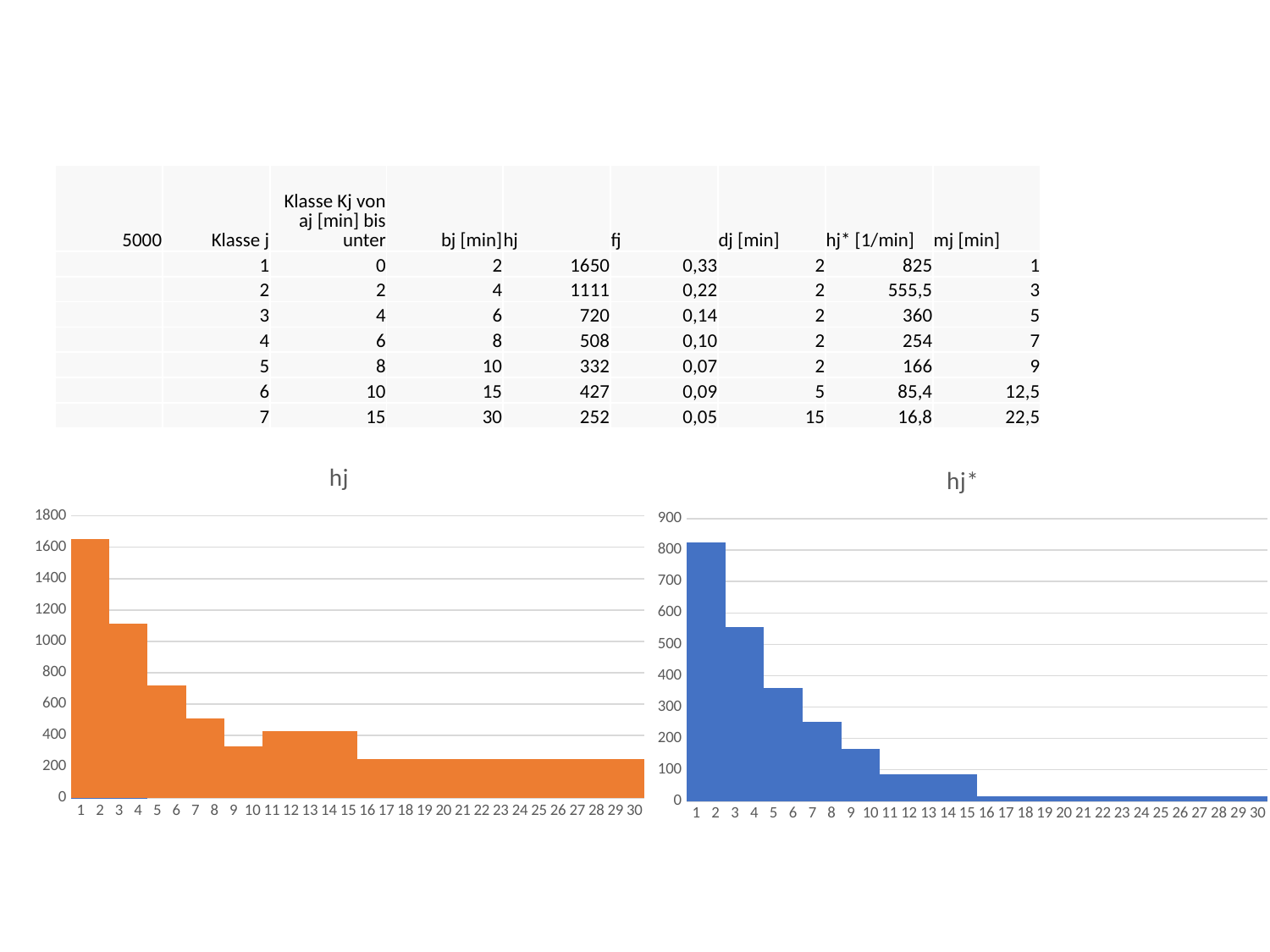
In the chart titled "hj*", is the value at x = 16 greater or less than 100? less What is the title of the left chart? hj In the chart titled "hj*", is the value at x = 5 greater or less than 400? less How many tick labels are shown on the x axis of the chart titled "hj"? 30 In the chart titled "hj", which is larger, the value at x = 9 or the value at x = 11? x = 11 What colour are the bars in the chart titled "hj*"? blue In the chart titled "hj", is the value at x = 16 greater or less than 400? less In the chart titled "hj*", do the values rise or fall as x increases? fall What kind of chart is the chart titled "hj"? bar chart